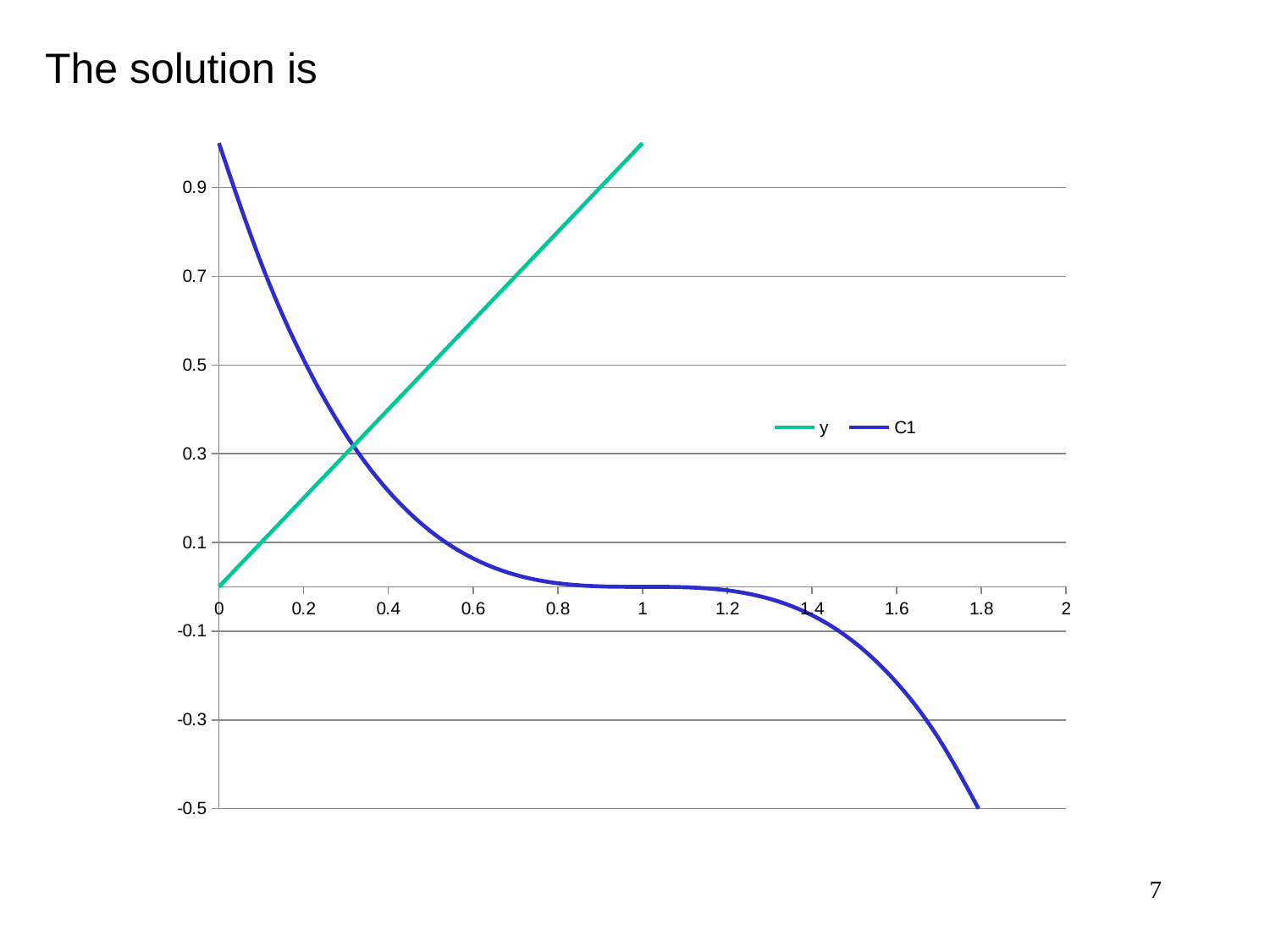
What are the names of the two series in the legend? y and C1 Which colour is used for the C1 series? blue What kind of chart is shown on the slide? line chart At x = 0.2, which series has the larger value, y or C1? C1 Is the value of the y series at x = 0.6 greater or less than 0.5? greater Is the value of the C1 series at x = 0.6 greater or less than 0.1? less Is the value of the C1 series at x = 0 greater or less than 0.9? greater Does the C1 series rise or fall overall as x increases from 0 to 1.8? fall At x = 0.6, which series has the larger value, y or C1? y How many series does the legend list? 2 Does the y series rise or fall as x increases? rise